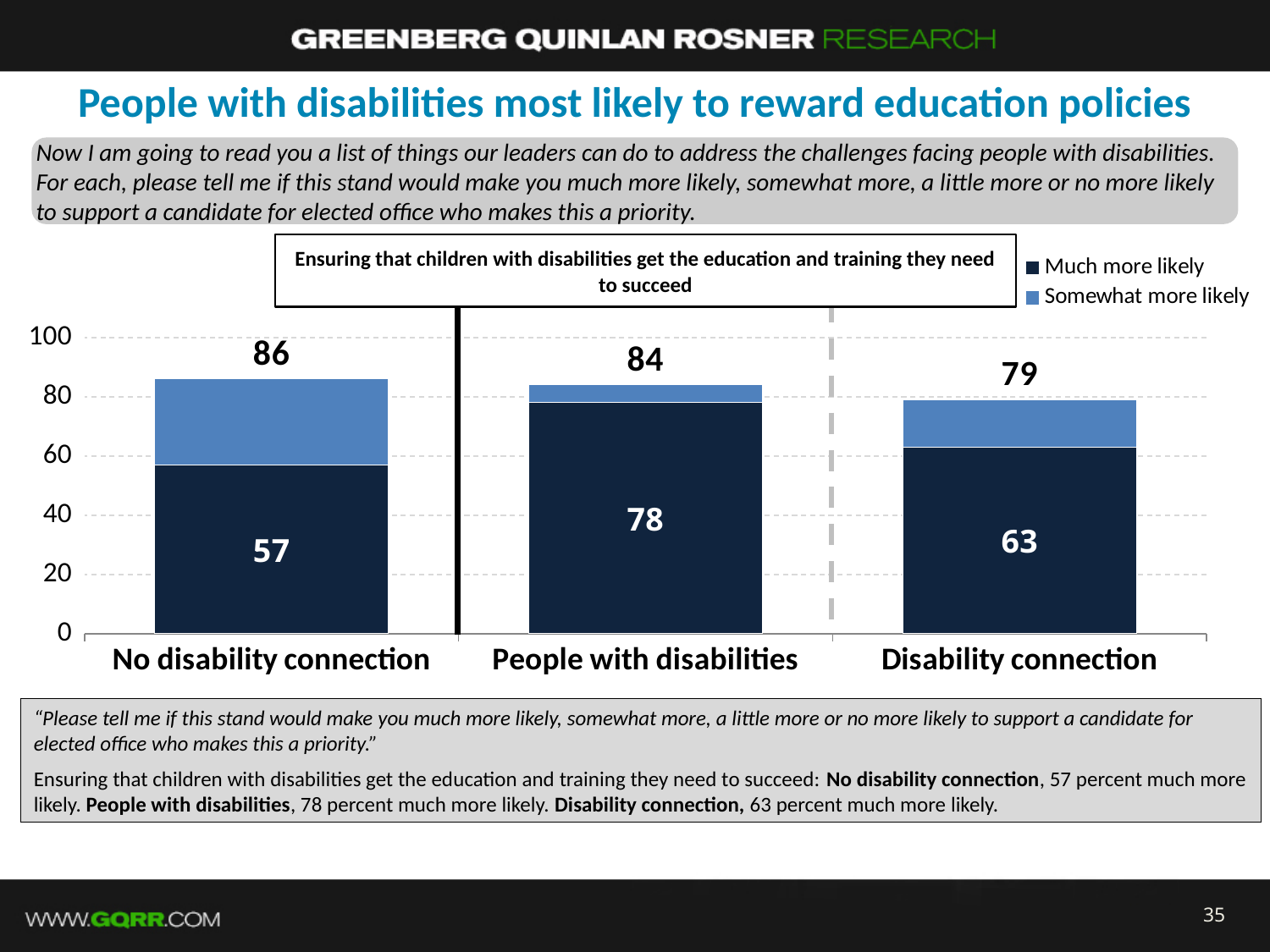
What is the difference between the 'Much more likely' values for People with disabilities and No disability connection? 21 Which category has the lowest combined total? Disability connection How many series does the legend list? 2 What type of chart is shown on the slide? Stacked bar chart Which category has the highest 'Much more likely' value? People with disabilities What is the 'Much more likely' value for People with disabilities? 78 How many categories are shown on the x axis? 3 What is the 'Much more likely' value for Disability connection? 63 Which is larger: the 'Much more likely' value for Disability connection or for No disability connection? Disability connection What is the total shown above the bar for No disability connection? 86 What is the 'Much more likely' value for No disability connection? 57 What is the total shown above the bar for Disability connection? 79